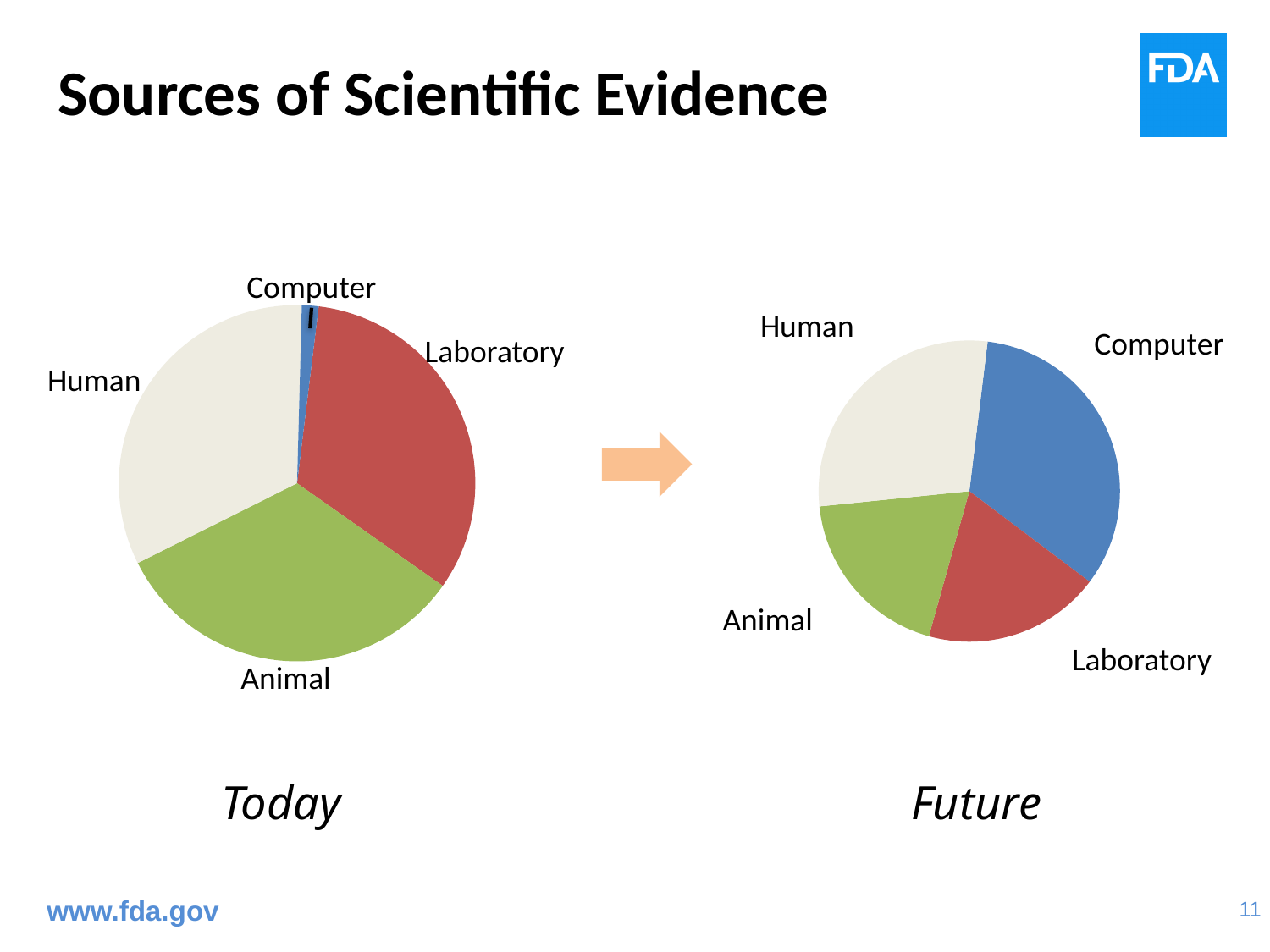
In the 'Future' pie chart, how many categories are shown? 4 In the 'Today' pie chart, which category has the smallest slice? Computer Comparing the two pie charts, does the Computer slice grow or shrink from 'Today' to 'Future'? Grow In the 'Future' pie chart, what colour is the Computer slice? Blue Comparing the two pie charts, does the Animal slice grow or shrink from 'Today' to 'Future'? Shrink What kind of chart is the 'Today' chart on the left? Pie chart In the 'Today' pie chart, how many slices are there? 4 What is the title of the slide containing the two pie charts? Sources of Scientific Evidence In the 'Today' pie chart, which slice is larger, Computer or Laboratory? Laboratory In the 'Future' pie chart, which slice is larger, Human or Animal? Human What kind of chart is the 'Future' chart on the right? Pie chart In the 'Future' pie chart, which slice is larger, Computer or Laboratory? Computer